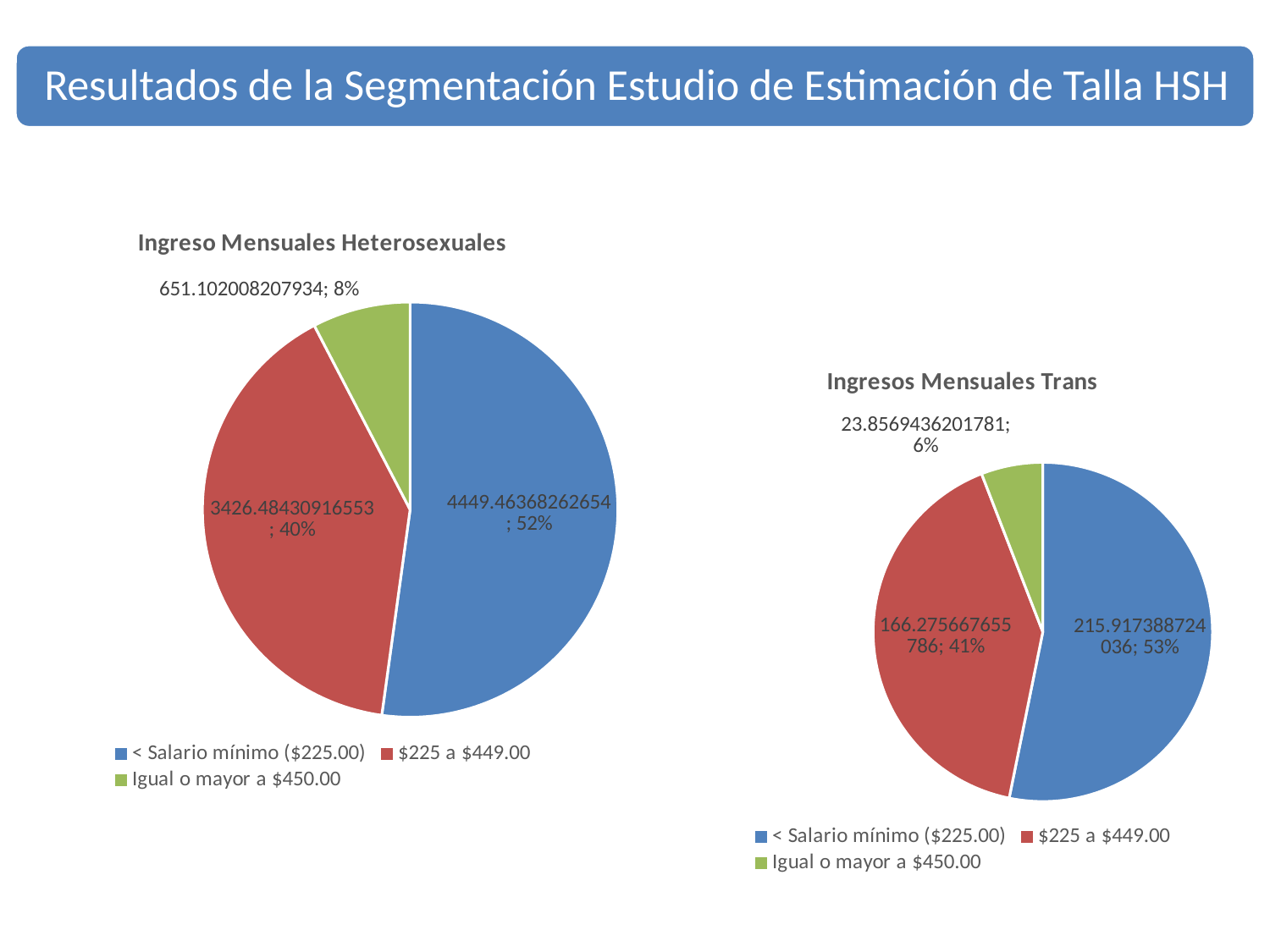
How many slices does the 'Ingreso Mensuales Heterosexuales' chart have? 3 In the 'Ingresos Mensuales Trans' chart, what value is labelled on the 'Igual o mayor a $450.00' slice? 23.8569436201781 In the 'Ingreso Mensuales Heterosexuales' chart, what share of the pie is the 'Igual o mayor a $450.00' slice? 8% In the 'Ingreso Mensuales Heterosexuales' chart, what share of the pie is the '< Salario mínimo ($225.00)' slice? 52% In the 'Ingreso Mensuales Heterosexuales' chart, which category has the largest slice? < Salario mínimo ($225.00) In the 'Ingreso Mensuales Heterosexuales' chart, which category has the smallest slice? Igual o mayor a $450.00 In the 'Ingresos Mensuales Trans' chart, which category has the smallest slice? Igual o mayor a $450.00 In the 'Ingreso Mensuales Heterosexuales' chart, what value is labelled on the '$225 a $449.00' slice? 3426.48430916553 What kind of chart is 'Ingresos Mensuales Trans'? Pie chart In the 'Ingresos Mensuales Trans' chart, which is larger: the '< Salario mínimo ($225.00)' slice or the '$225 a $449.00' slice? < Salario mínimo ($225.00) In the 'Ingresos Mensuales Trans' chart, what value is labelled on the '< Salario mínimo ($225.00)' slice? 215.917388724036 In the 'Ingresos Mensuales Trans' chart, what share of the pie is the '$225 a $449.00' slice? 41%